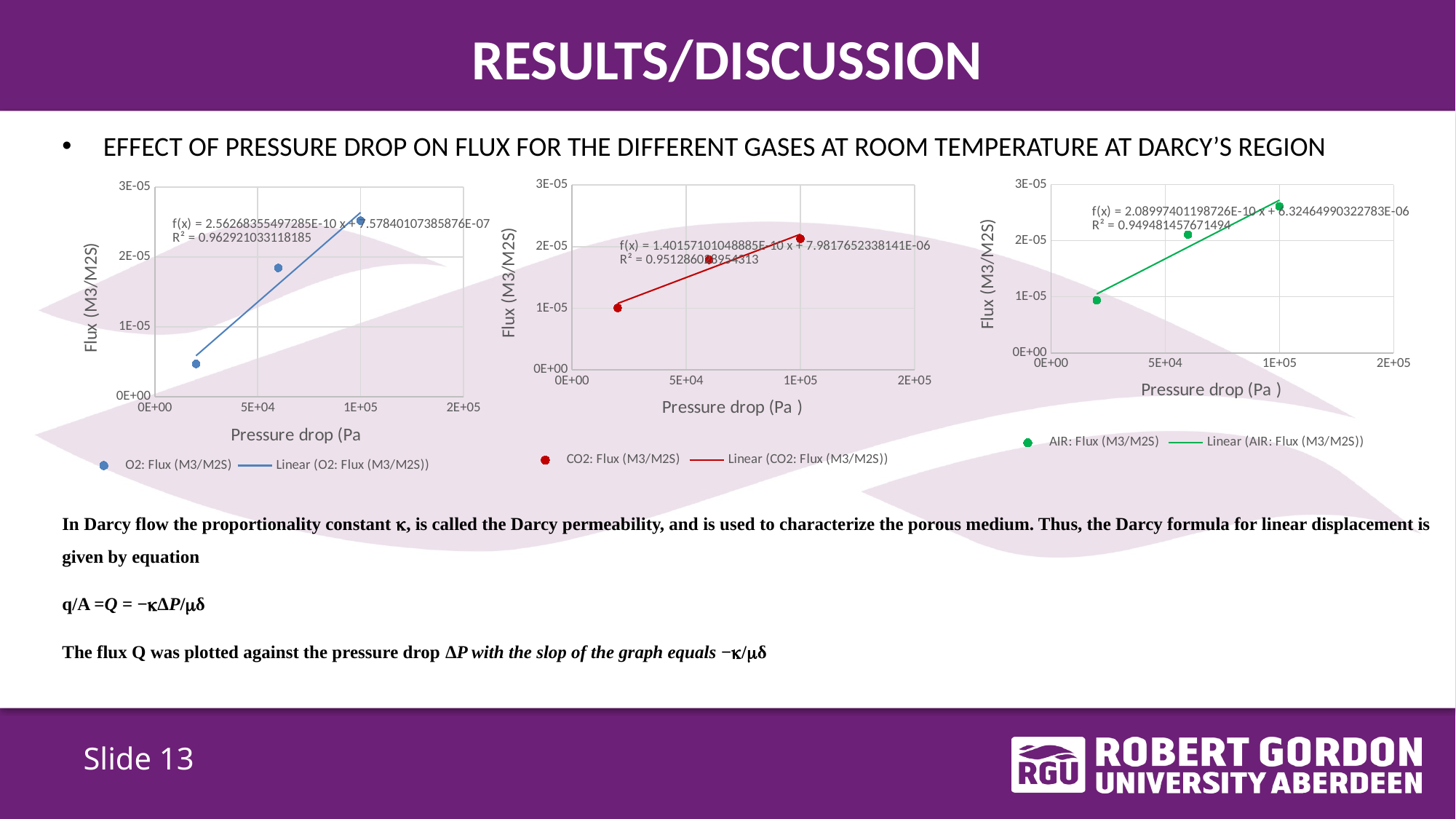
What is the x-axis title of the middle chart (CO2: Flux)? Pressure drop (Pa ) In the middle chart (CO2: Flux), which plotted point has the highest flux: the one at the lowest pressure drop or the one at the highest pressure drop? the one at the highest pressure drop In the middle chart (CO2: Flux), is the flux value at a pressure drop of 1E+05 greater or less than 2E-05? greater In the right chart (AIR: Flux), is the flux value at a pressure drop of 1E+05 greater or less than 2E-05? greater In the left chart (O2: Flux), does flux rise or fall as pressure drop increases? rise How many data points are plotted in the middle chart (CO2: Flux)? 3 What is the R² value shown on the left chart (O2: Flux)? 0.962921033118185 What is the R² value shown on the right chart (AIR: Flux)? 0.949481457671494 How many entries does the legend of the right chart (AIR: Flux) list? 2 What kind of chart is the left chart (O2: Flux)? scatter chart In the left chart (O2: Flux), is the flux value at the lowest pressure drop greater or less than 1E-05? less